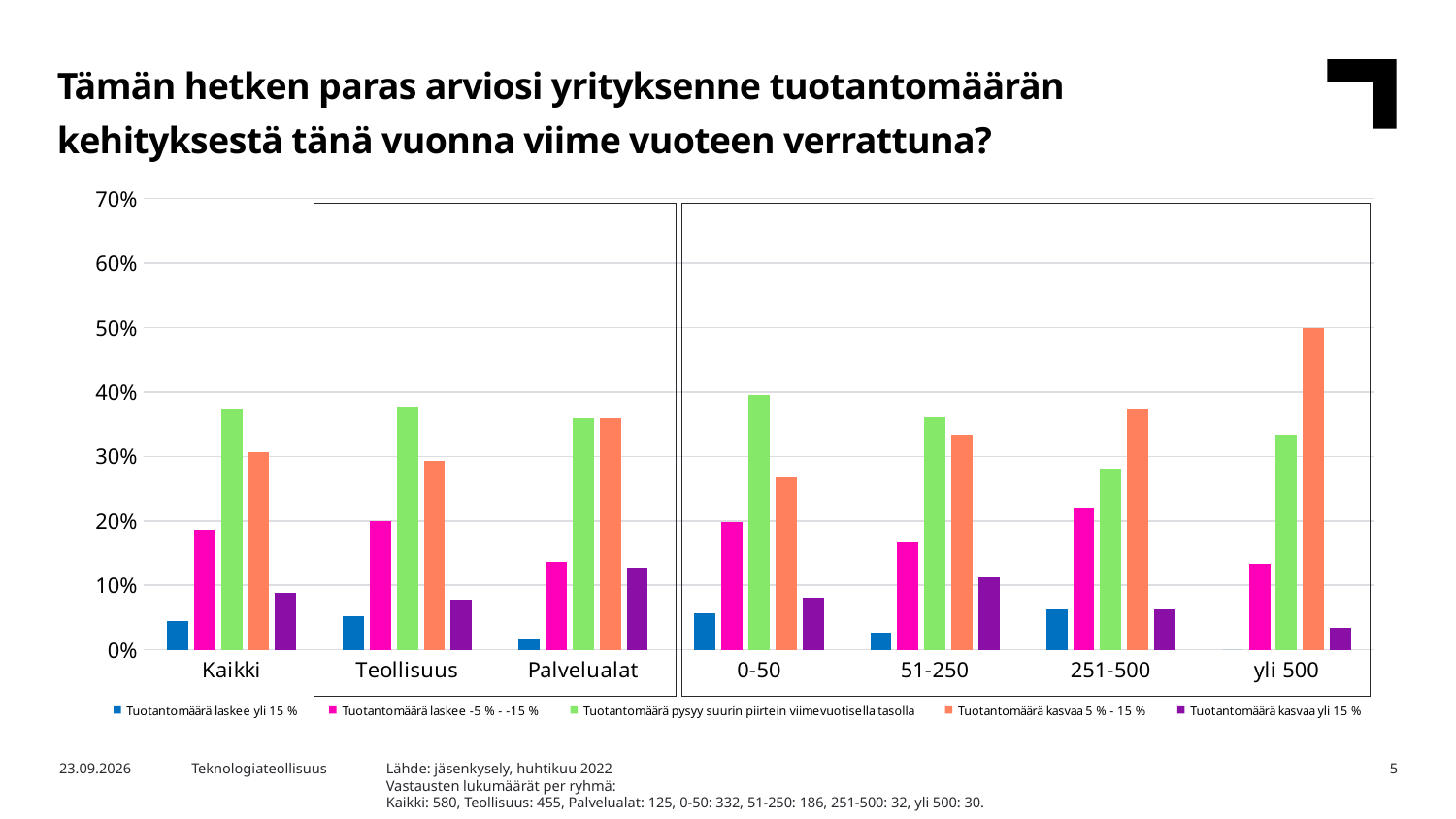
What is the highest value shown on the chart's y axis? 70% Which category has the highest value for 'Tuotantomäärä kasvaa 5 % - 15 %'? yli 500 How many categories are shown along the x axis of the chart? 7 Which series has the highest value in the '0-50' category? Tuotantomäärä pysyy suurin piirtein viimevuotisella tasolla Is the value of 'Tuotantomäärä laskee yli 15 %' for 'Kaikki' greater or less than 10%? less In the '251-500' category, which is larger: 'Tuotantomäärä kasvaa 5 % - 15 %' or 'Tuotantomäärä pysyy suurin piirtein viimevuotisella tasolla'? Tuotantomäärä kasvaa 5 % - 15 % What kind of chart is shown on the slide? bar chart Is the value of 'Tuotantomäärä kasvaa yli 15 %' for 'yli 500' greater or less than 10%? less Is the value of 'Tuotantomäärä pysyy suurin piirtein viimevuotisella tasolla' for '0-50' greater or less than 30%? greater How many series does the chart's legend list? 5 In the 'Kaikki' category, which is larger: 'Tuotantomäärä pysyy suurin piirtein viimevuotisella tasolla' or 'Tuotantomäärä kasvaa 5 % - 15 %'? Tuotantomäärä pysyy suurin piirtein viimevuotisella tasolla